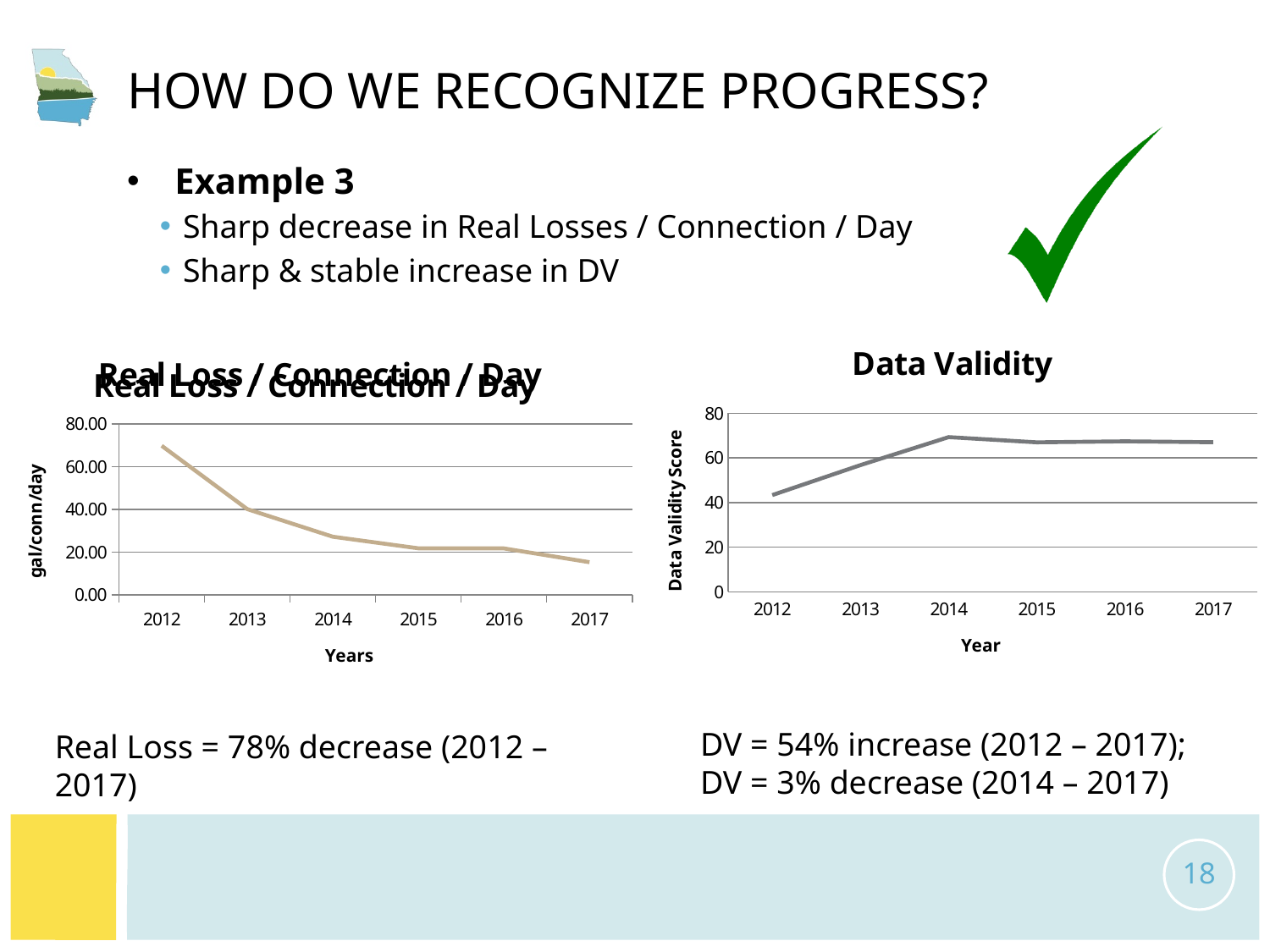
In the "Data Validity" chart, do the values rise or fall from 2012 to 2014? rise In the "Data Validity" chart, which year has the lowest value? 2012 In the "Real Loss / Connection / Day" chart, which year has the lowest value? 2017 What is the y-axis title of the "Real Loss / Connection / Day" chart? gal/conn/day In the "Data Validity" chart, is the value for 2014 greater or less than 60? greater What kind of chart is the "Data Validity" chart? line chart How many years are plotted on the x axis of the "Data Validity" chart? 6 In the "Real Loss / Connection / Day" chart, do the values rise or fall from 2012 to 2017? fall What kind of chart is the "Real Loss / Connection / Day" chart? line chart In the "Real Loss / Connection / Day" chart, is the value for 2012 greater or less than 60.00? greater How many years are plotted on the x axis of the "Real Loss / Connection / Day" chart? 6 In the "Real Loss / Connection / Day" chart, which year has the highest value? 2012